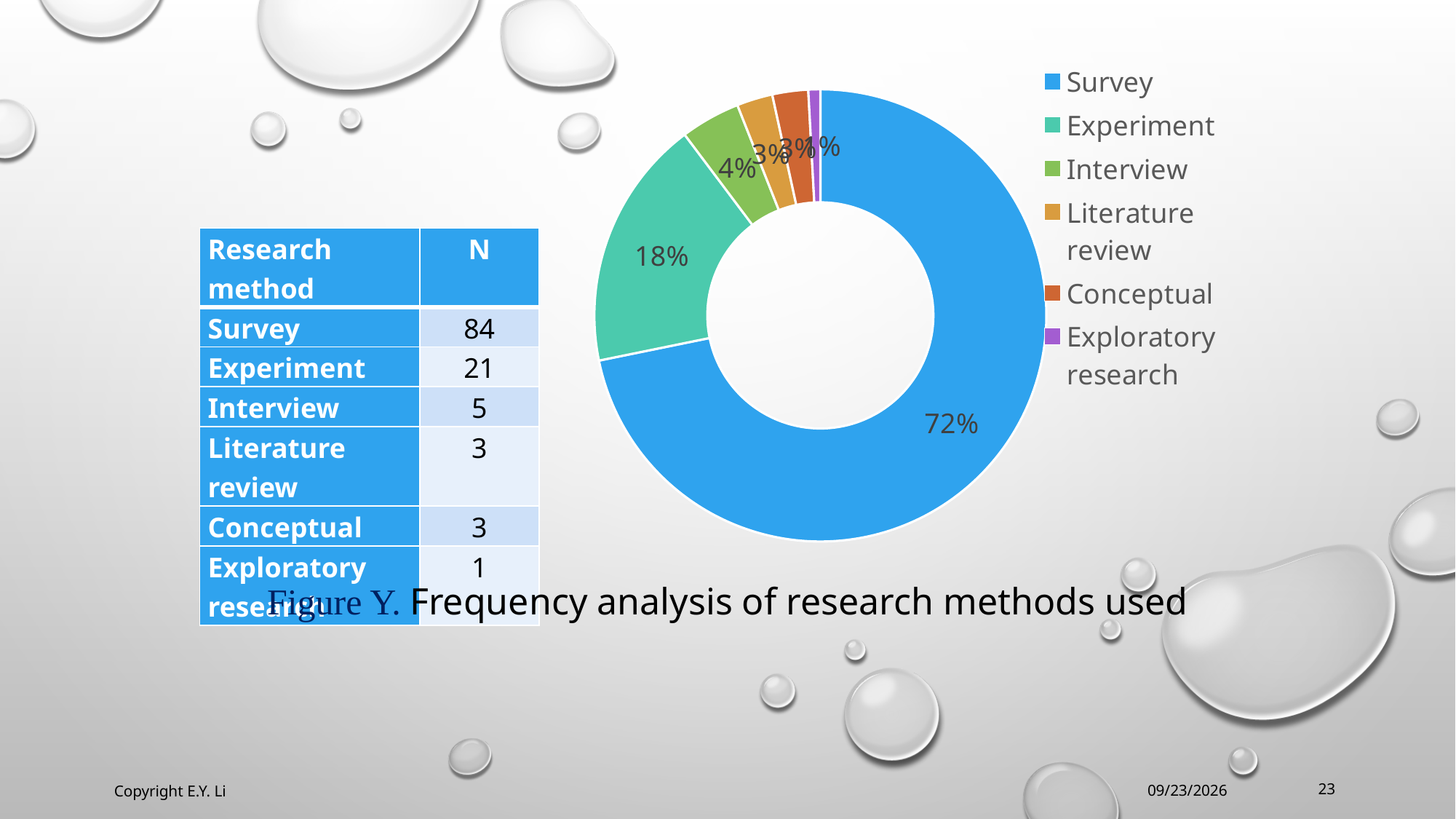
What colour is the Survey slice in the chart? blue What is the difference between the Survey and Experiment percentages? 54% How many entries does the chart legend list? 6 What is the value shown for Conceptual in the chart? 3% What percentage of the chart does Survey account for? 72% What is the value shown for Interview in the chart? 4% Which research method has the smallest slice in the chart? Exploratory research What kind of chart is shown on the slide? doughnut chart Which is larger in the chart, Experiment or Interview? Experiment What is the value shown for Experiment in the chart? 18% Which research method has the largest slice in the chart? Survey How many research methods are shown in the chart? 6